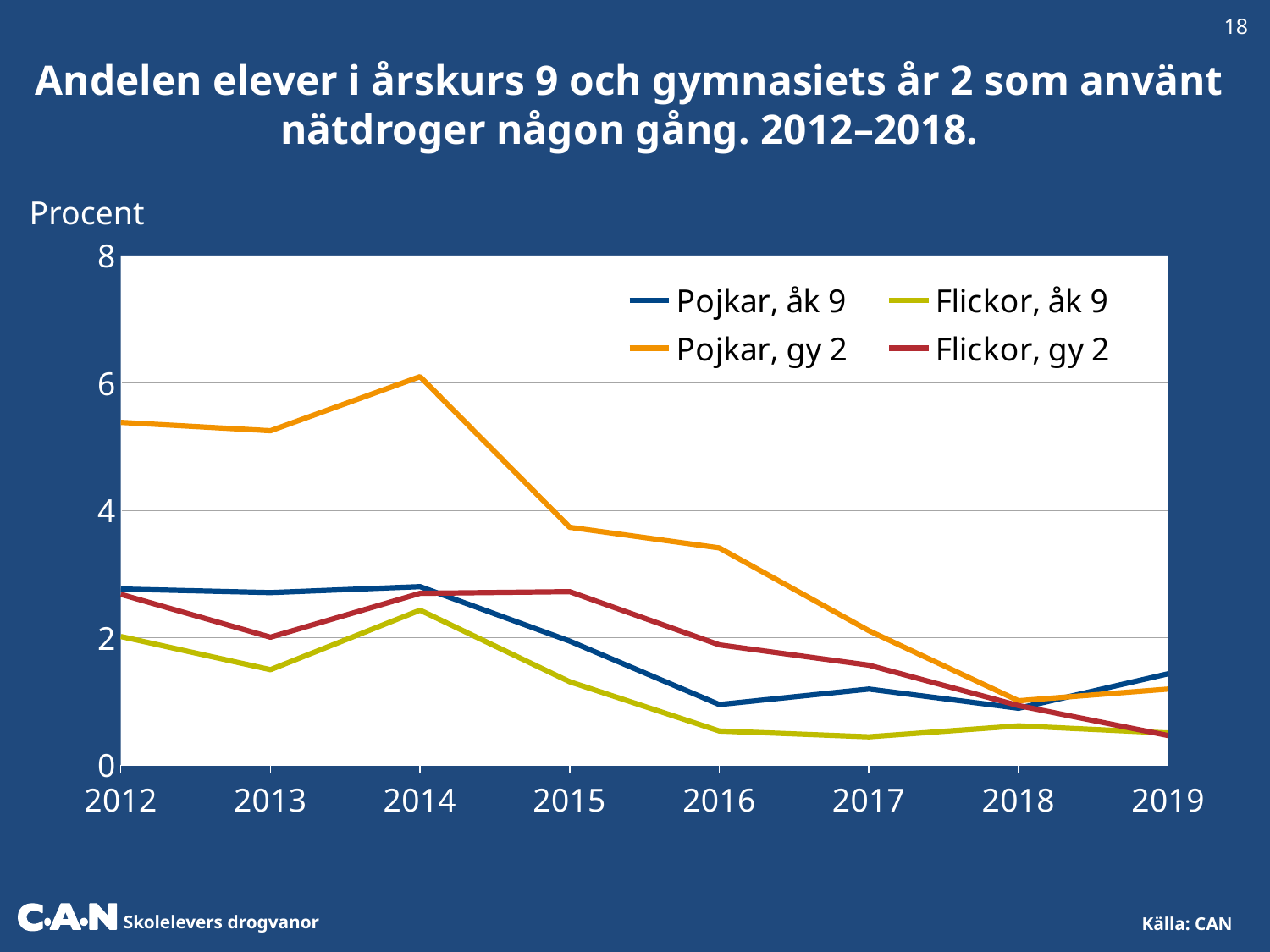
Does the Pojkar, gy 2 series rise or fall from 2014 to 2018? Fall Which series has the highest value in 2014? Pojkar, gy 2 Which series has the lowest value in 2016? Flickor, åk 9 How many series does the legend list? 4 What kind of chart is shown on the slide? Line chart What unit label is shown above the y axis? Procent How many years are shown on the x axis? 8 In which year does the Pojkar, gy 2 series reach its highest value? 2014 Is the value for Pojkar, gy 2 in 2014 greater or less than 4? greater In 2015, which is larger: Pojkar, gy 2 or Flickor, gy 2? Pojkar, gy 2 Is the value for Flickor, åk 9 in 2017 greater or less than 2? less Is the value for Pojkar, gy 2 in 2012 greater or less than 4? greater